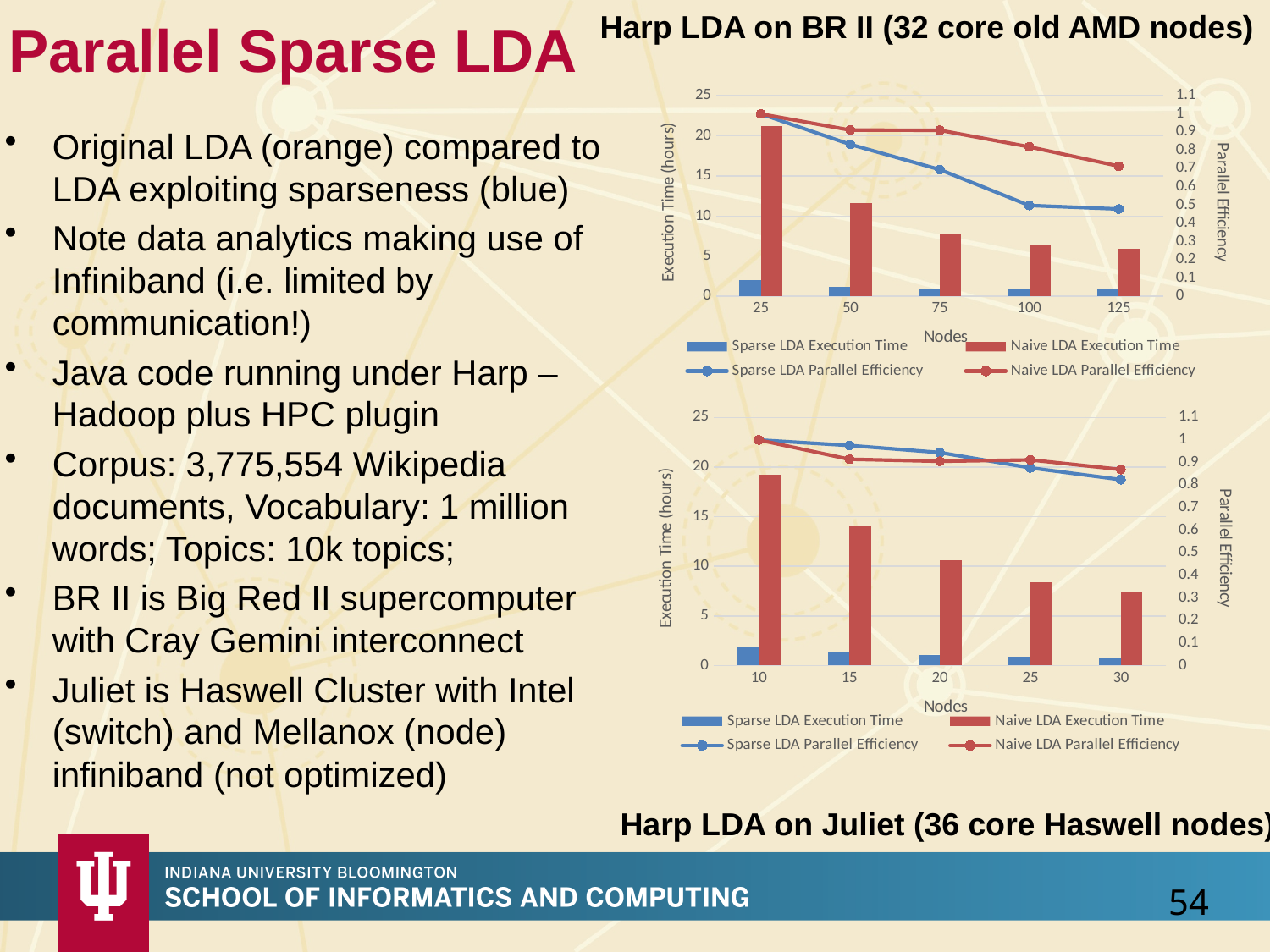
In the 'Harp LDA on Juliet (36 core Haswell nodes)' chart, what is the label of the left vertical axis? Execution Time (hours) In the 'Harp LDA on BR II (32 core old AMD nodes)' chart, how many node counts are shown on the x axis? 5 In the 'Harp LDA on Juliet (36 core Haswell nodes)' chart, does the Naive LDA Execution Time rise or fall as the number of nodes increases? fall In the 'Harp LDA on BR II (32 core old AMD nodes)' chart, is the Naive LDA Execution Time at 125 nodes greater or less than 10? less In the 'Harp LDA on BR II (32 core old AMD nodes)' chart, is the Naive LDA Execution Time at 25 nodes greater or less than 20? greater In the 'Harp LDA on BR II (32 core old AMD nodes)' chart, how many series does the legend list? 4 In the 'Harp LDA on Juliet (36 core Haswell nodes)' chart, at which node count is the Naive LDA Execution Time lowest? 30 In the 'Harp LDA on BR II (32 core old AMD nodes)' chart, at which node count is the Naive LDA Execution Time highest? 25 In the 'Harp LDA on BR II (32 core old AMD nodes)' chart, at 100 nodes, which is larger: the Naive LDA Execution Time or the Sparse LDA Execution Time? Naive LDA Execution Time In the 'Harp LDA on Juliet (36 core Haswell nodes)' chart, how many node counts are shown on the x axis? 5 In the 'Harp LDA on Juliet (36 core Haswell nodes)' chart, is the Naive LDA Execution Time at 10 nodes greater or less than 15? greater In the 'Harp LDA on BR II (32 core old AMD nodes)' chart, does the Sparse LDA Parallel Efficiency rise or fall as the number of nodes increases? fall